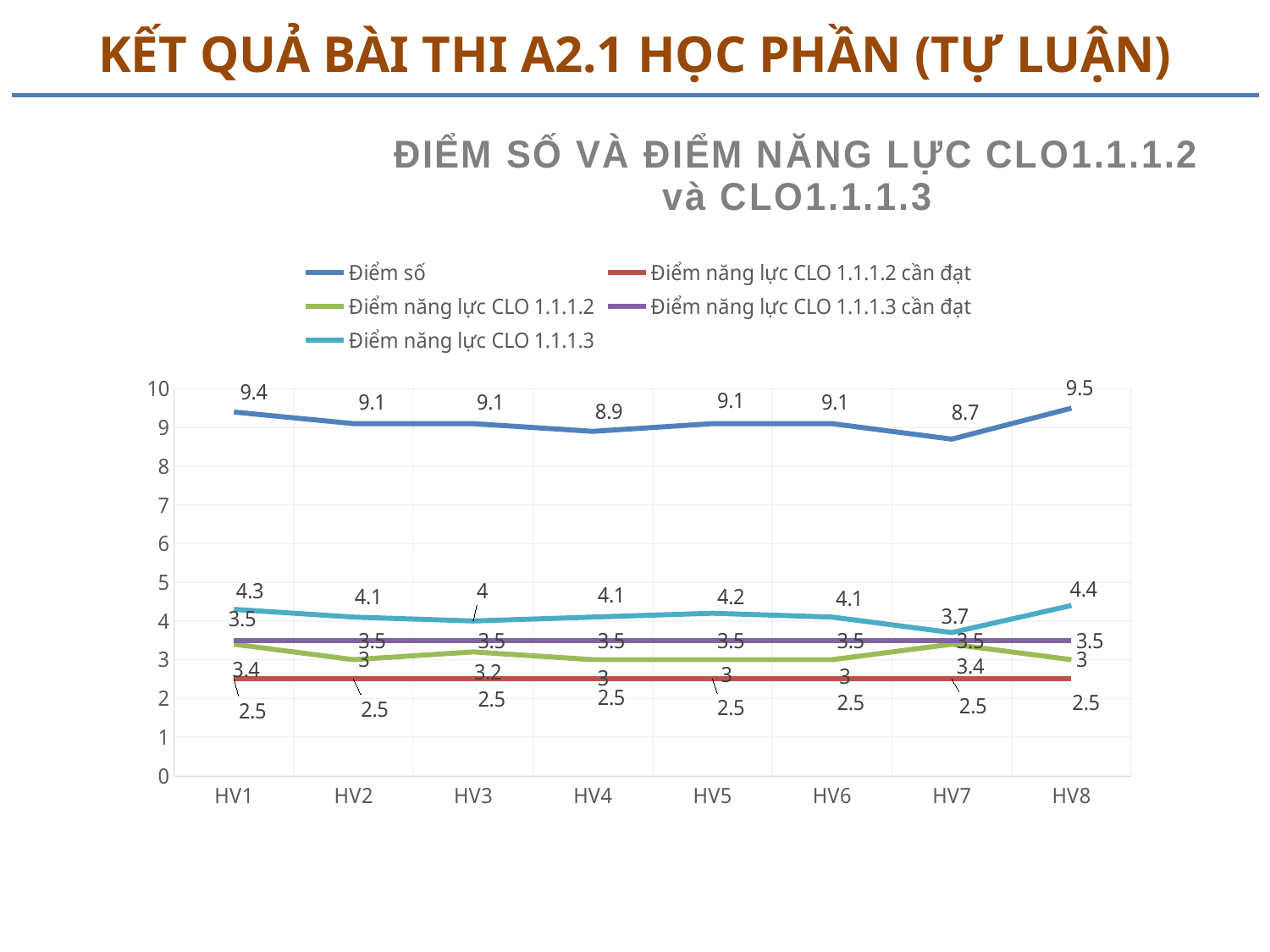
What is the value of Điểm năng lực CLO 1.1.1.2 for HV3? 3.2 How many categories (HV) are shown on the x axis? 8 What is the title of the chart? ĐIỂM SỐ VÀ ĐIỂM NĂNG LỰC CLO1.1.1.2 và CLO1.1.1.3 What is the difference between the Điểm số for HV8 and HV7? 0.8 Which is larger: Điểm năng lực CLO 1.1.1.3 for HV8 or for HV7? HV8 Which category has the highest Điểm số? HV8 What type of chart is shown on the slide? line chart What is the value of Điểm năng lực CLO 1.1.1.2 cần đạt for HV4? 2.5 What is the value of Điểm số for HV1? 9.4 Which category has the lowest Điểm số? HV7 How many series does the legend list? 5 What is the value of Điểm năng lực CLO 1.1.1.3 for HV7? 3.7